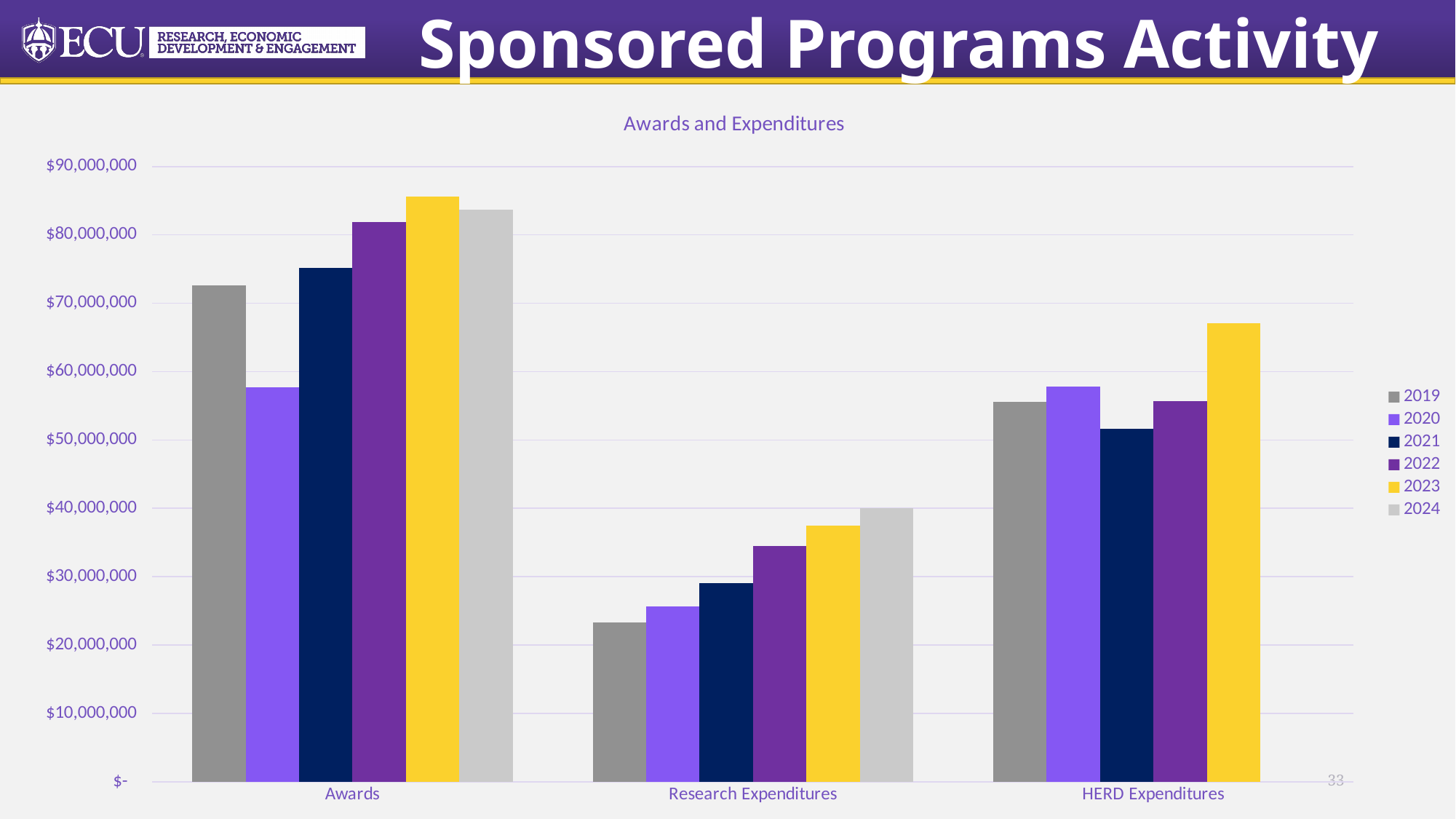
How many series does the legend list? 6 Which year has the lowest value in the HERD Expenditures category? 2021 Do the Research Expenditures values rise or fall from 2019 to 2024? rise What is the title of the chart? Awards and Expenditures How many categories are shown along the x axis? 3 Is the 2021 value for Research Expenditures greater or less than $30,000,000? less Which year has the lowest value in the Awards category? 2020 Which is larger: the 2022 value for Awards or the 2023 value for HERD Expenditures? 2022 Awards Which year has the highest value in the Research Expenditures category? 2024 Is the 2019 value for Awards greater or less than $70,000,000? greater Which year has the highest value in the Awards category? 2023 What kind of chart is shown on the slide? Bar chart